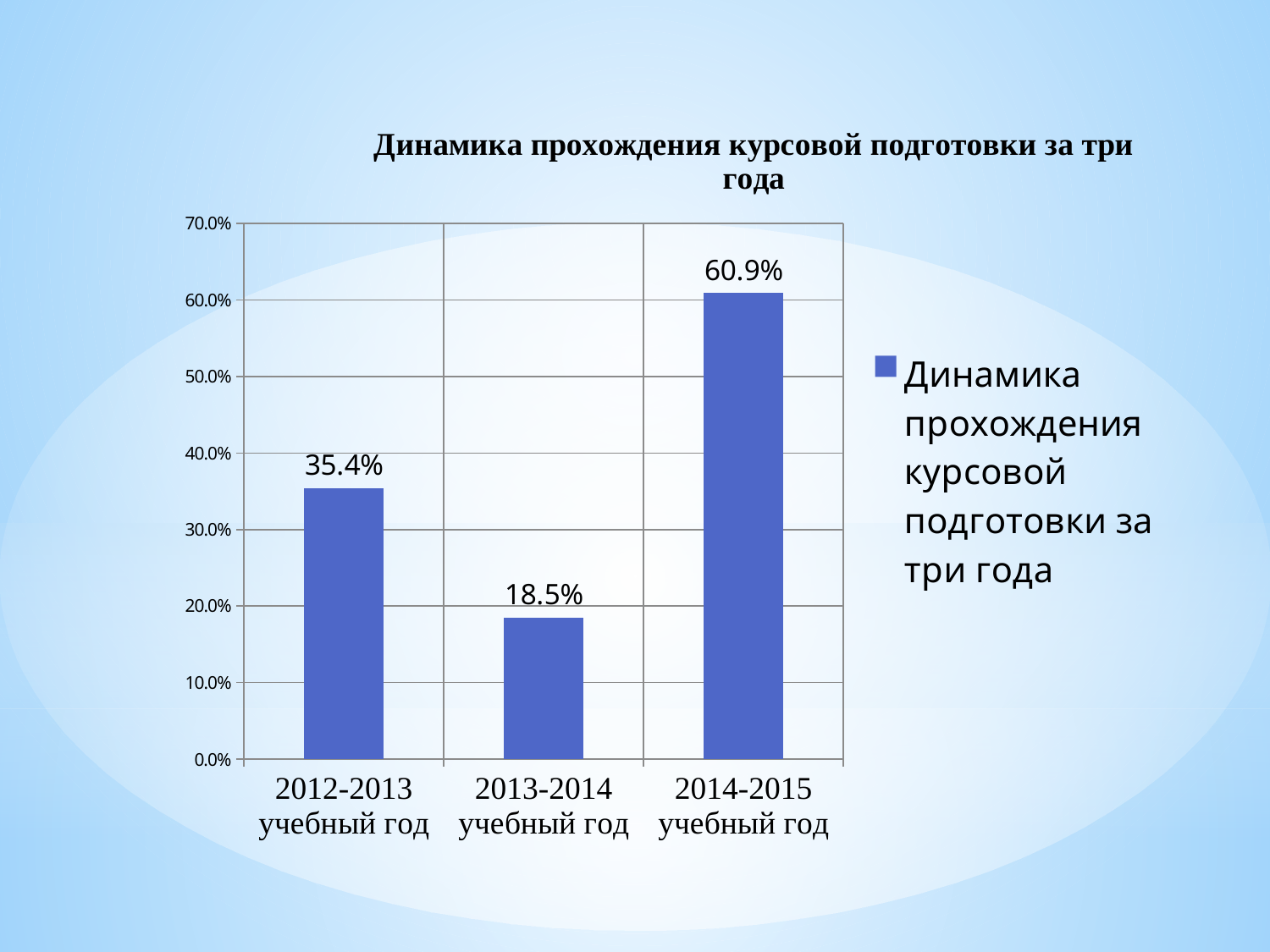
Which academic year has the lowest value? 2013-2014 учебный год What is the value for 2014-2015 учебный год? 60.9% Which academic year has the highest value? 2014-2015 учебный год Is the value for 2014-2015 учебный год greater or less than 50.0%? greater What is the title of the chart? Динамика прохождения курсовой подготовки за три года What kind of chart is shown on the slide? bar chart How many academic years are shown on the x axis? 3 What is the difference between the values for 2014-2015 учебный год and 2012-2013 учебный год? 25.5% Which is larger, the value for 2012-2013 учебный год or 2013-2014 учебный год? 2012-2013 учебный год What is the difference between the values for 2012-2013 учебный год and 2013-2014 учебный год? 16.9% What is the value for 2013-2014 учебный год? 18.5% What is the value for 2012-2013 учебный год? 35.4%